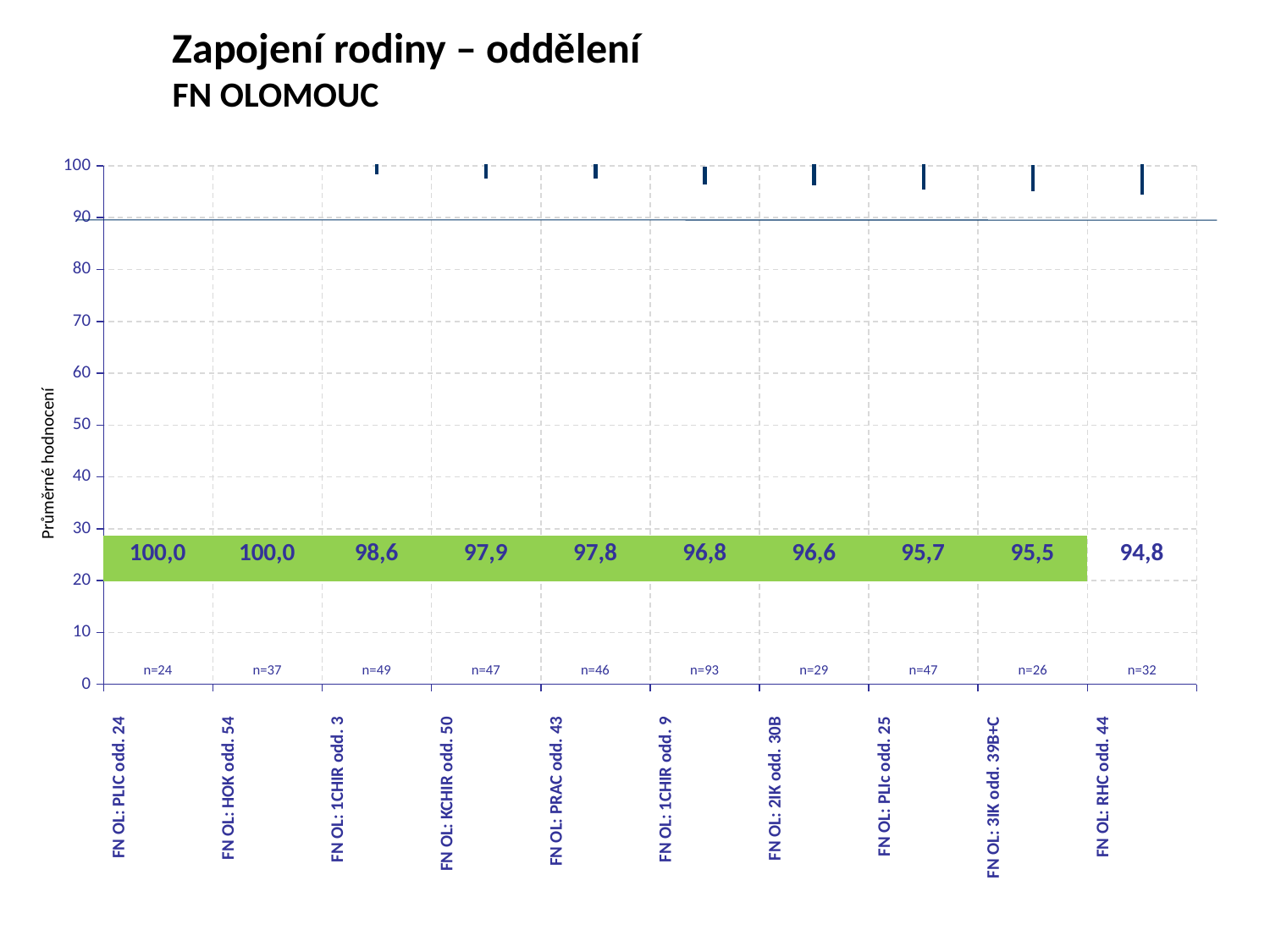
What is the value for FN OL: 1CHIR odd. 3? 98,6 How many categories are shown on the x axis? 10 What is the sample size (n) shown for FN OL: 1CHIR odd. 9? n=93 What is the difference between the values for FN OL: PLIC odd. 24 and FN OL: RHC odd. 44? 5,2 What is the value for FN OL: 2IK odd. 30B? 96,6 Which is larger, the value for FN OL: PRAC odd. 43 or the value for FN OL: PLIc odd. 25? FN OL: PRAC odd. 43 Is the value for FN OL: 3IK odd. 39B+C greater or less than 90? greater What is the difference between the values for FN OL: 1CHIR odd. 3 and FN OL: KCHIR odd. 50? 0,7 Do the values rise or fall from left to right along the x axis? fall What is the value for FN OL: RHC odd. 44? 94,8 What kind of chart is shown on the slide? stock (high-low) chart Which category has the lowest value? FN OL: RHC odd. 44